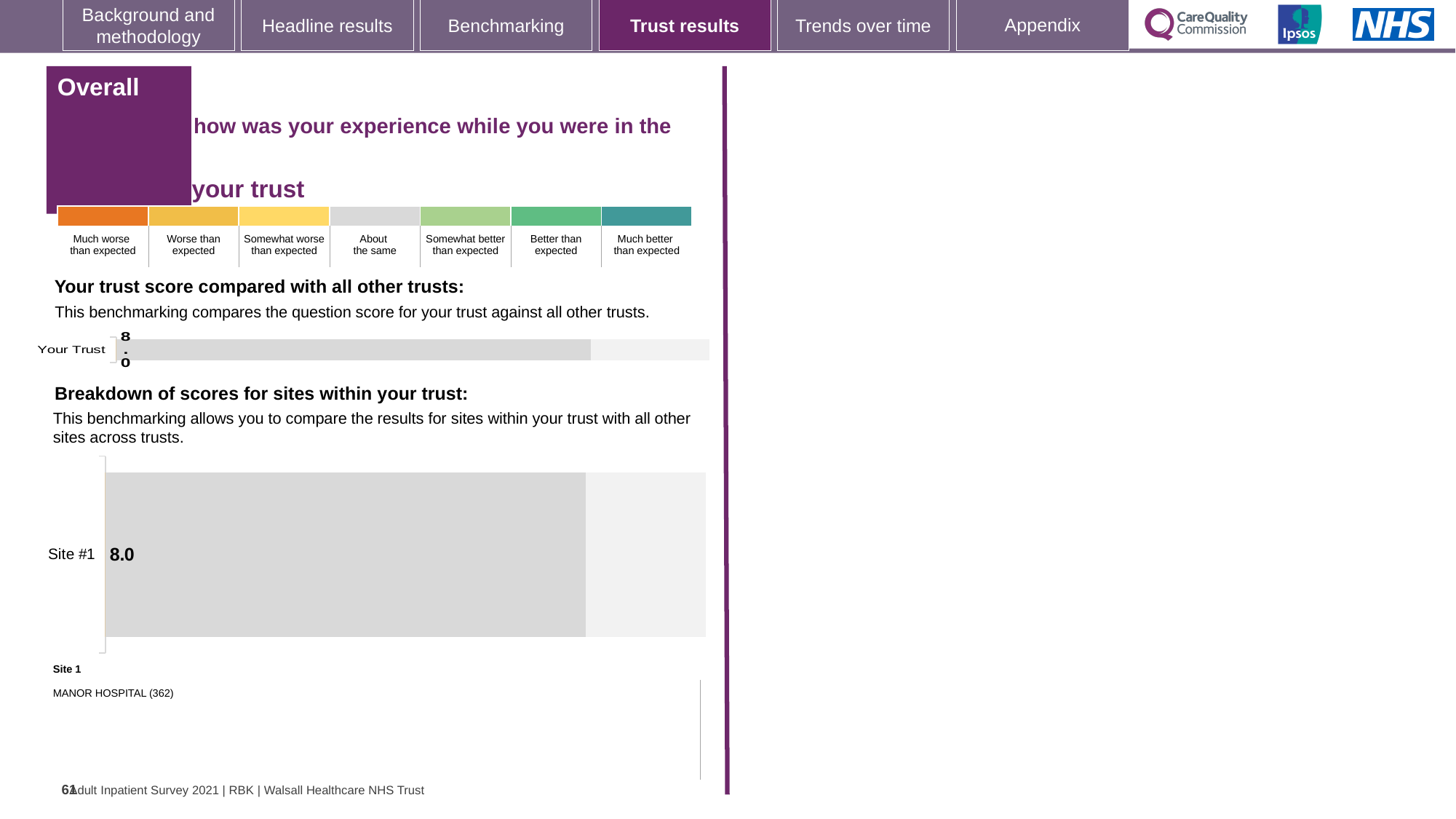
In the 'Your trust score compared with all other trusts' chart, what is the value for Your Trust? 8.0 In the 'Breakdown of scores for sites within your trust' chart, what is the value for Site #1? 8.0 How many sites are plotted in the 'Breakdown of scores for sites within your trust' chart? 1 What kind of chart is the 'Your trust score compared with all other trusts' chart? bar chart How many rating categories does the colour key above the charts list, from 'Much worse than expected' to 'Much better than expected'? 7 How many categories are plotted in the 'Your trust score compared with all other trusts' chart? 1 What is the difference between the Your Trust score in the top chart and the Site #1 score in the bottom chart? 0.0 In the 'Breakdown of scores for sites within your trust' chart, which hospital does Site 1 refer to? MANOR HOSPITAL (362) What kind of chart is the 'Breakdown of scores for sites within your trust' chart? bar chart